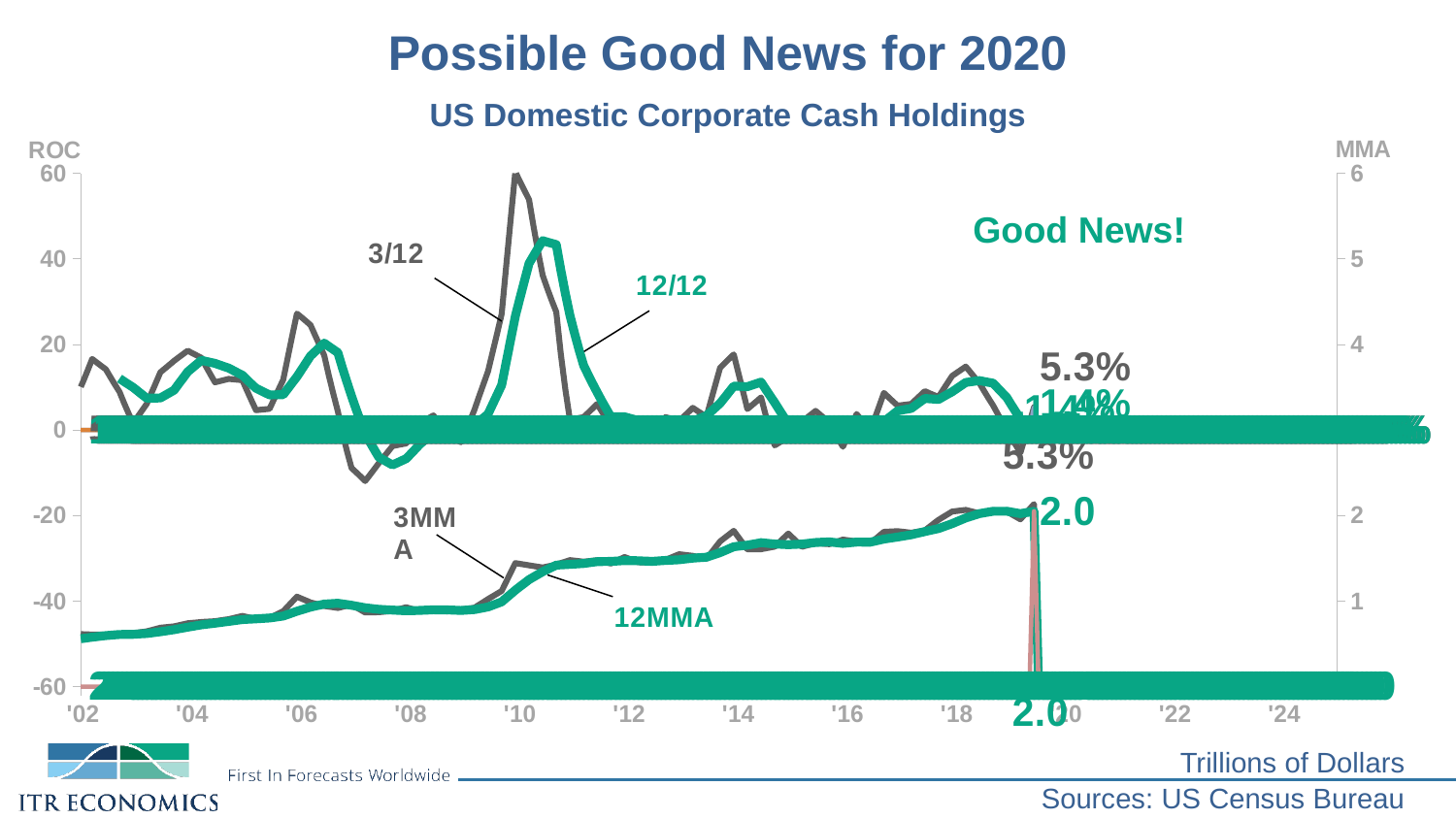
What kind of chart is shown on the slide? line chart How many year labels are shown on the x axis of the chart? 12 How many labelled lines (series) are plotted on the chart? 4 What is the title of the chart on the slide? US Domestic Corporate Cash Holdings Is the peak of the 3/12 line around '10 greater or less than 40 on the ROC axis? greater Is the peak of the 12/12 line around '10 greater or less than 20 on the ROC axis? greater Is the 12MMA value around '16 greater or less than 1 on the MMA axis? greater Which line reaches a higher peak around '10, the 3/12 line or the 12/12 line? 3/12 What is the latest value labelled at the end of the 12MMA line? 2.0 Does the 12MMA line generally rise or fall from '02 to '18? rise What is the label on the left vertical axis of the chart? ROC